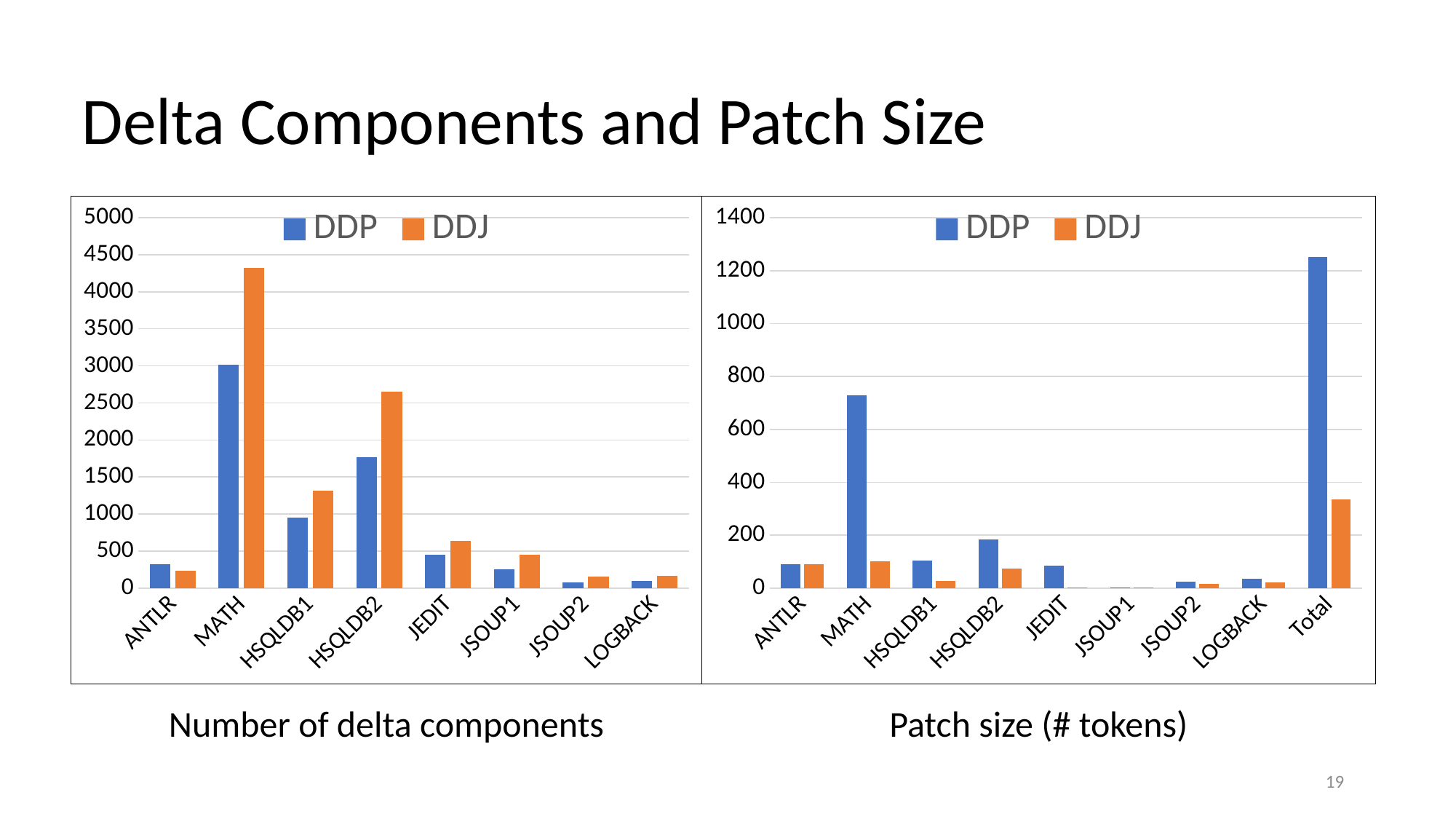
In the 'Patch size (# tokens)' chart, is the DDP value for Total greater or less than 1200? greater In the 'Number of delta components' chart, is the DDJ value for MATH greater or less than 4000? greater In the 'Number of delta components' chart, which is larger for HSQLDB1, DDP or DDJ? DDJ In the 'Number of delta components' chart, which category has the highest DDJ value? MATH In the 'Patch size (# tokens)' chart, is the DDP value for MATH greater or less than 600? greater In the 'Number of delta components' chart, which is larger for ANTLR, DDP or DDJ? DDP In the 'Patch size (# tokens)' chart, which is larger for HSQLDB2, DDP or DDJ? DDP How many categories are shown on the x axis of the 'Patch size (# tokens)' chart? 9 How many series does the legend of the 'Patch size (# tokens)' chart list? 2 How many categories are shown on the x axis of the 'Number of delta components' chart? 8 In the 'Patch size (# tokens)' chart, which category has the highest DDP value? Total